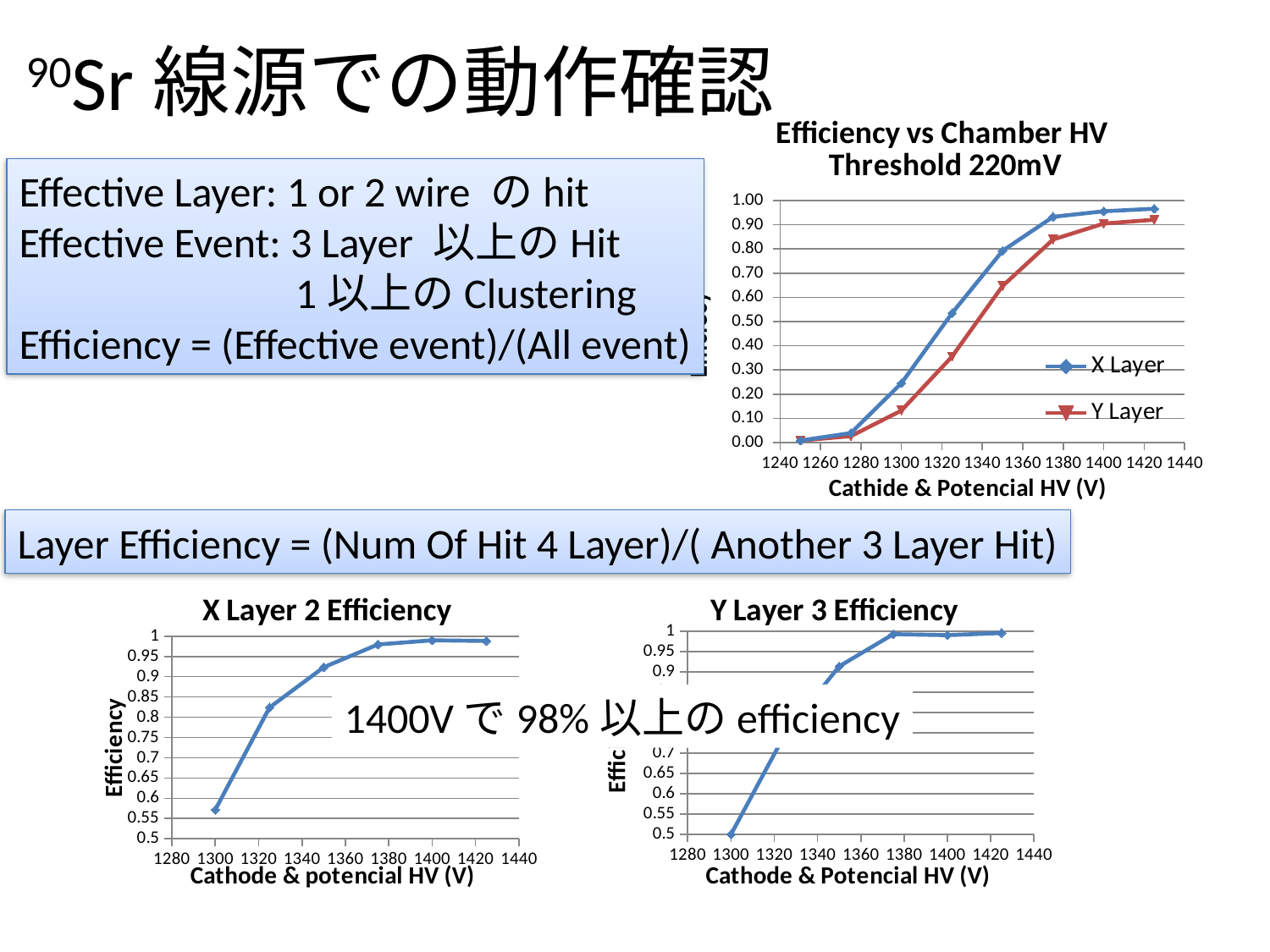
In the 'X Layer 2 Efficiency' chart, is the value at 1300 V greater or less than 0.6? less In the 'X Layer 2 Efficiency' chart, is the value at 1375 V greater or less than 0.95? greater How many data points are plotted in the 'X Layer 2 Efficiency' chart? 6 What are the legend entries of the 'Efficiency vs Chamber HV Threshold 220mV' chart? X Layer, Y Layer In the 'Efficiency vs Chamber HV Threshold 220mV' chart, which series has the higher efficiency at 1300 V, X Layer or Y Layer? X Layer In the 'X Layer 2 Efficiency' chart, at which HV value is the efficiency lowest? 1300 In the 'Efficiency vs Chamber HV Threshold 220mV' chart, is the Y Layer value at 1325 V greater or less than 0.40? less How many series does the legend of the 'Efficiency vs Chamber HV Threshold 220mV' chart list? 2 In the 'Efficiency vs Chamber HV Threshold 220mV' chart, do the efficiency values rise or fall as the HV increases? rise How many data points does the X Layer series have in the 'Efficiency vs Chamber HV Threshold 220mV' chart? 8 What kind of chart is the 'Efficiency vs Chamber HV Threshold 220mV' chart? Line chart